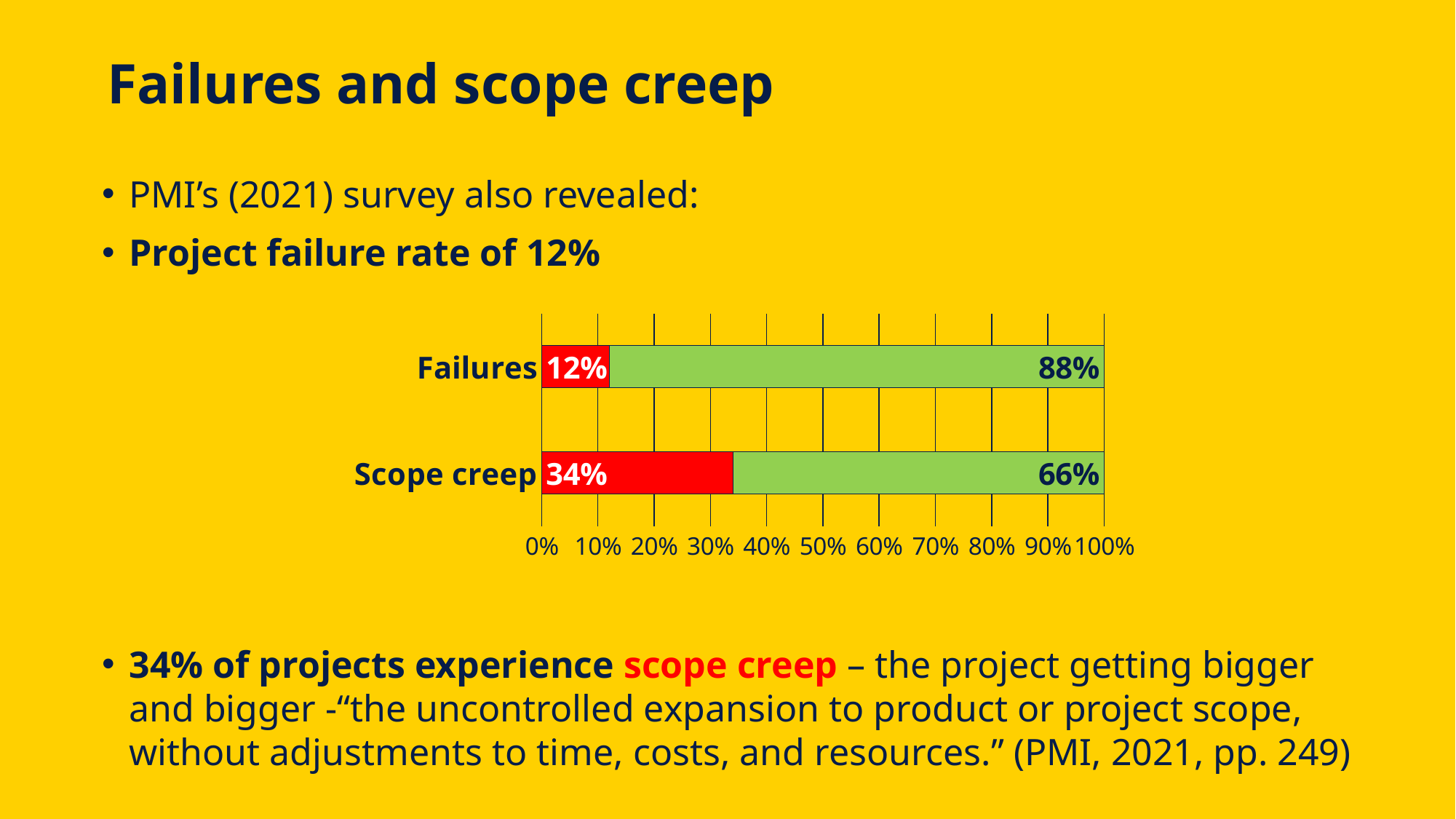
What is the green segment value for Failures? 88% Which category has the larger green segment? Failures What is the maximum value shown on the x axis? 100% What is the difference between the red segment values for Scope creep and Failures? 22% What is the red segment value for Failures? 12% Is the red segment for Scope creep greater or less than 30%? greater What is the red segment value for Scope creep? 34% What is the green segment value for Scope creep? 66% What is the total of the Scope creep stacked bar? 100% What kind of chart is shown on the slide? Stacked bar chart Which category has the larger red segment, Failures or Scope creep? Scope creep How many categories are shown on the chart? 2